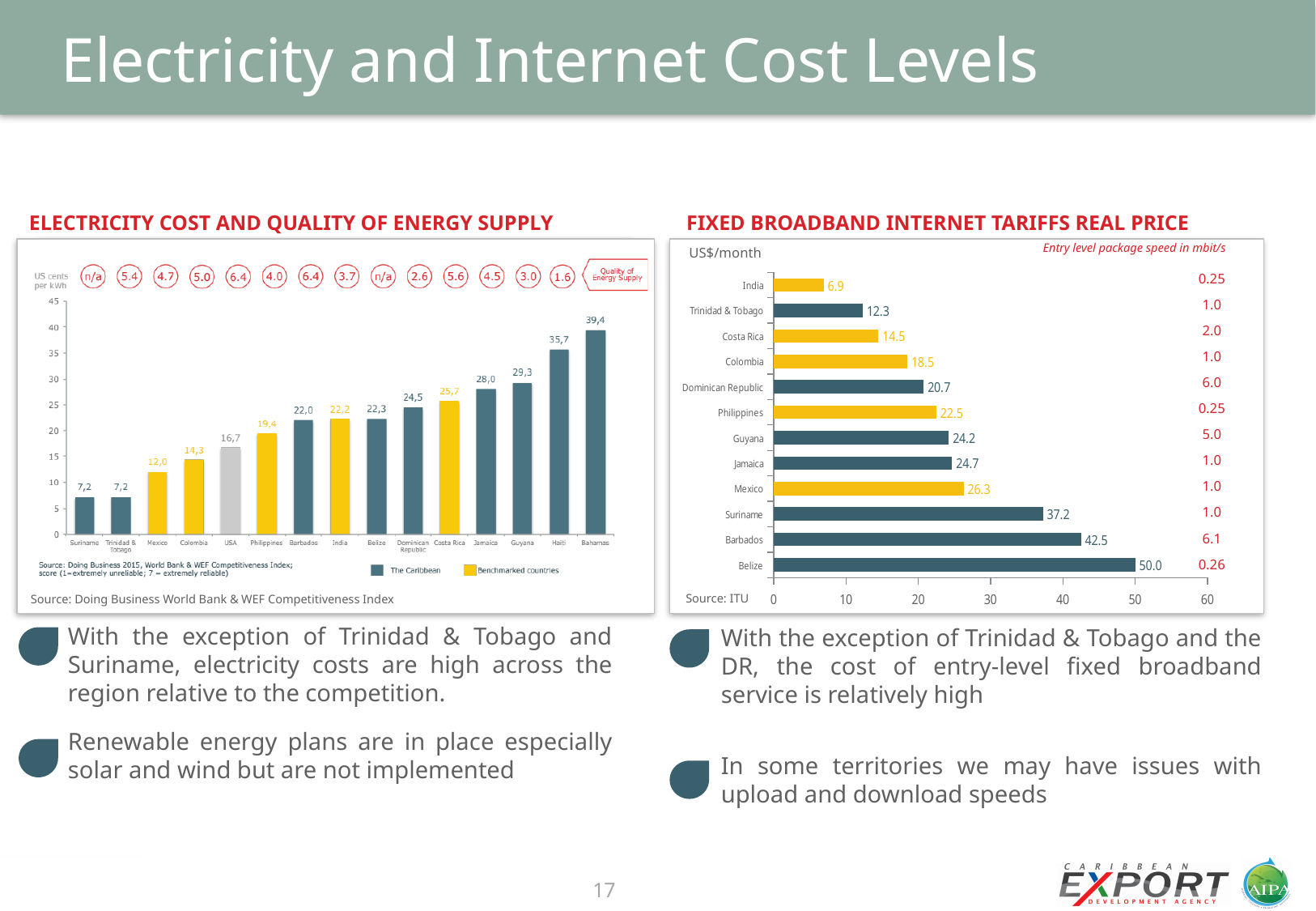
In the Electricity Cost and Quality of Energy Supply chart, which is larger, the value for Jamaica or the value for Costa Rica? Jamaica In the Electricity Cost and Quality of Energy Supply chart, what is the value for Haiti? 35,7 In the Fixed Broadband Internet Tariffs Real Price chart, what is the value for Belize? 50.0 In the Electricity Cost and Quality of Energy Supply chart, how many series does the legend list? 2 In the Electricity Cost and Quality of Energy Supply chart, which country has the highest electricity cost? Bahamas In the Fixed Broadband Internet Tariffs Real Price chart, is the value for Mexico greater or less than 30? less In the Fixed Broadband Internet Tariffs Real Price chart, how many countries are plotted? 12 In the Electricity Cost and Quality of Energy Supply chart, how many countries are plotted? 15 In the Fixed Broadband Internet Tariffs Real Price chart, what is the value for Trinidad & Tobago? 12.3 In the Fixed Broadband Internet Tariffs Real Price chart, what is the difference between the values for Barbados and Suriname? 5.3 In the Fixed Broadband Internet Tariffs Real Price chart, which country has the lowest tariff? India What kind of chart is the Fixed Broadband Internet Tariffs Real Price chart? bar chart